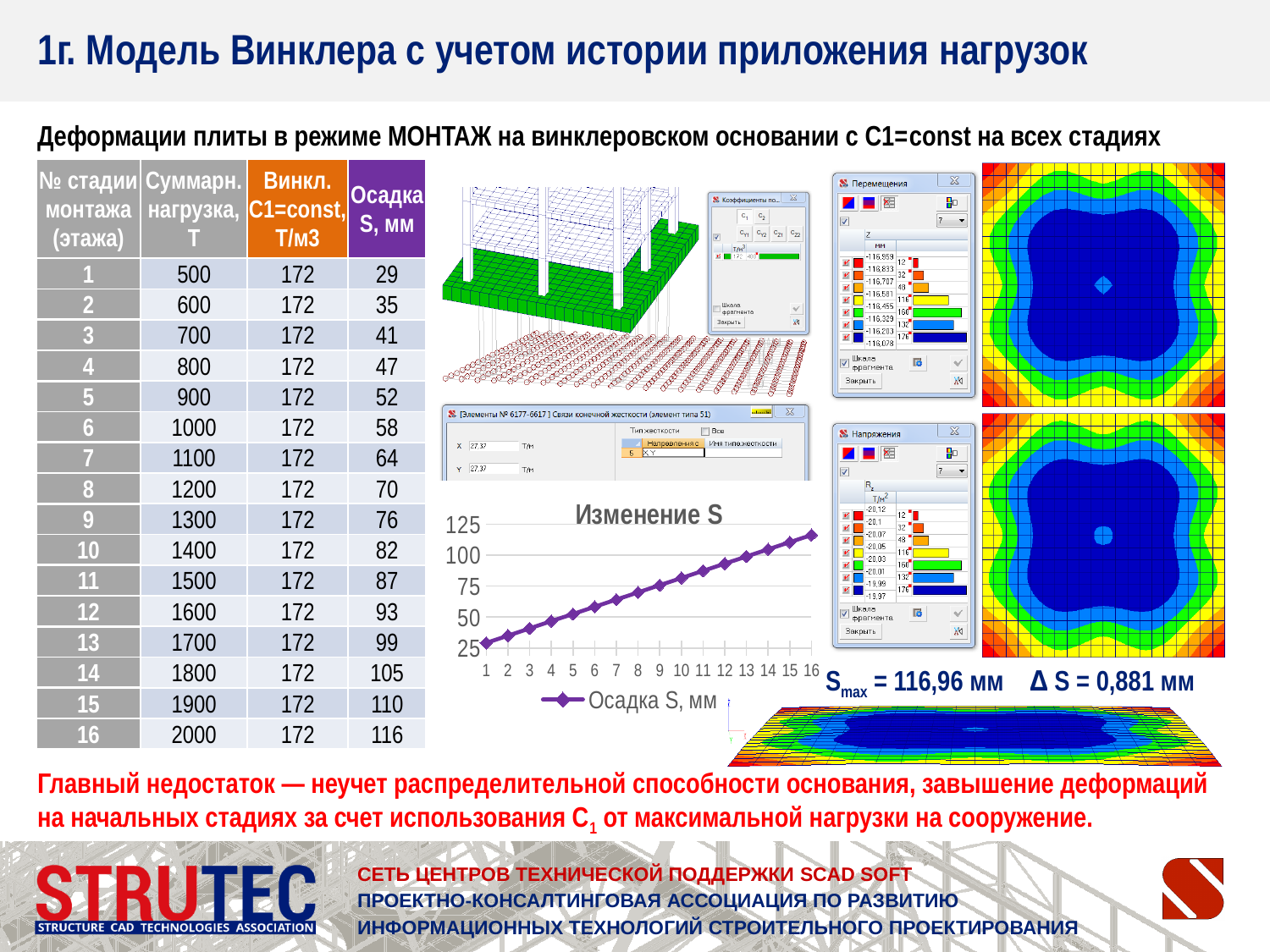
How many series does the legend of the "Изменение S" chart list? 1 In the "Изменение S" chart, is the value at stage 2 greater or less than 50? less What kind of chart is "Изменение S"? line chart In the "Изменение S" chart, which stage has the lowest value? 1 Do the values in the "Изменение S" chart rise or fall from stage 1 to stage 16? rise In the "Изменение S" chart, is the value at stage 16 greater or less than 100? greater What series name does the legend of the "Изменение S" chart show? Осадка S, мм What is the title of the chart on the slide? Изменение S In the "Изменение S" chart, is the value at stage 12 greater or less than 100? less How many points are plotted along the x axis of the "Изменение S" chart? 16 In the "Изменение S" chart, which stage has the highest value? 16